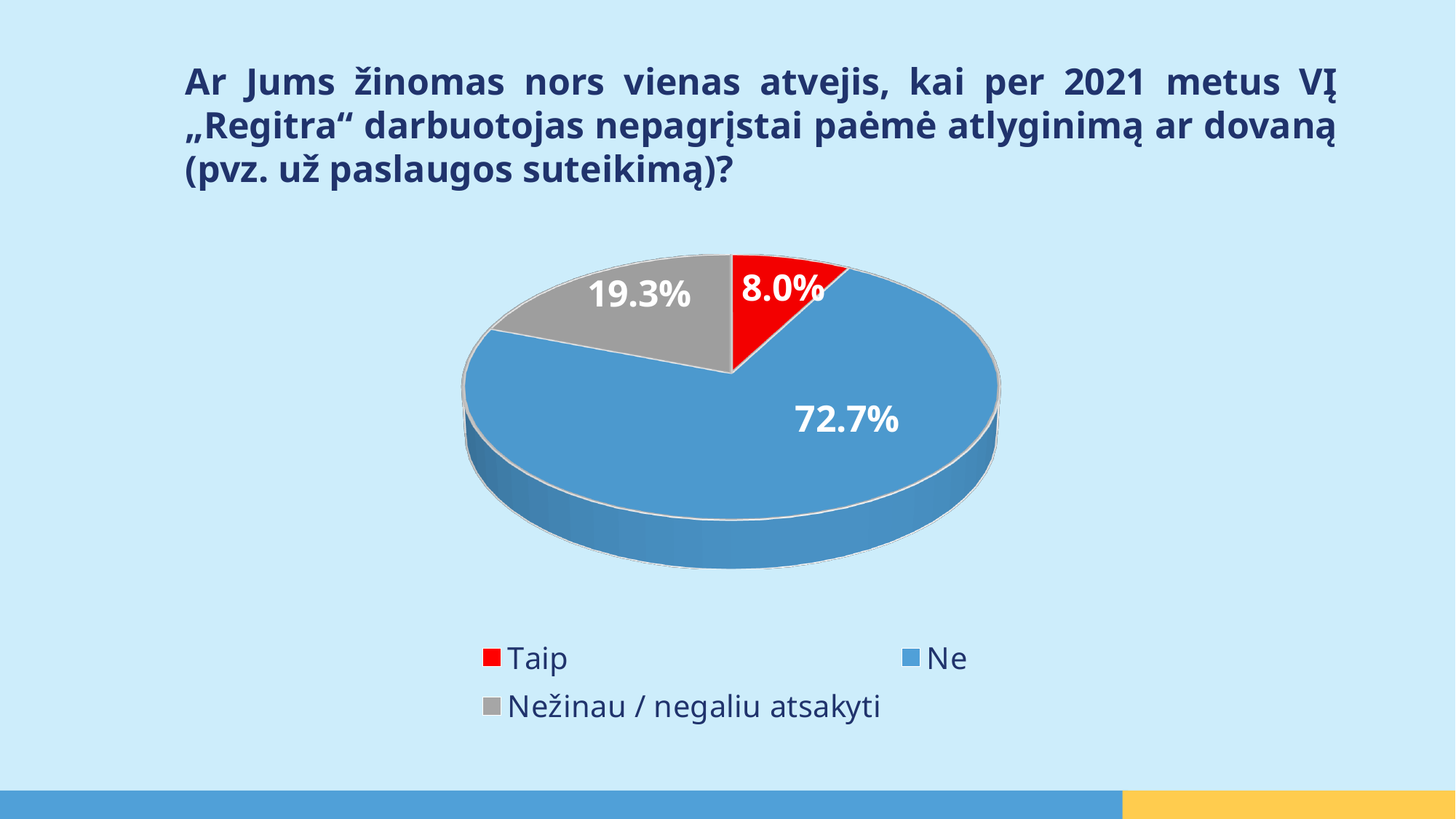
What percentage of respondents answered "Taip"? 8.0% How many slices does the pie chart have? 3 What is the difference in percentage points between "Ne" and "Nežinau / negaliu atsakyti"? 53.4 What is the difference in percentage points between "Nežinau / negaliu atsakyti" and "Taip"? 11.3 What percentage of respondents answered "Nežinau / negaliu atsakyti"? 19.3% Which answer has the smallest share of the pie? Taip What kind of chart is shown on the slide? Pie chart What percentage of respondents answered "Ne"? 72.7% Which answer has the largest share of the pie? Ne What colour is the slice for "Taip"? Red What colour is the slice for "Nežinau / negaliu atsakyti"? Grey Which is larger, the share for "Taip" or the share for "Nežinau / negaliu atsakyti"? Nežinau / negaliu atsakyti